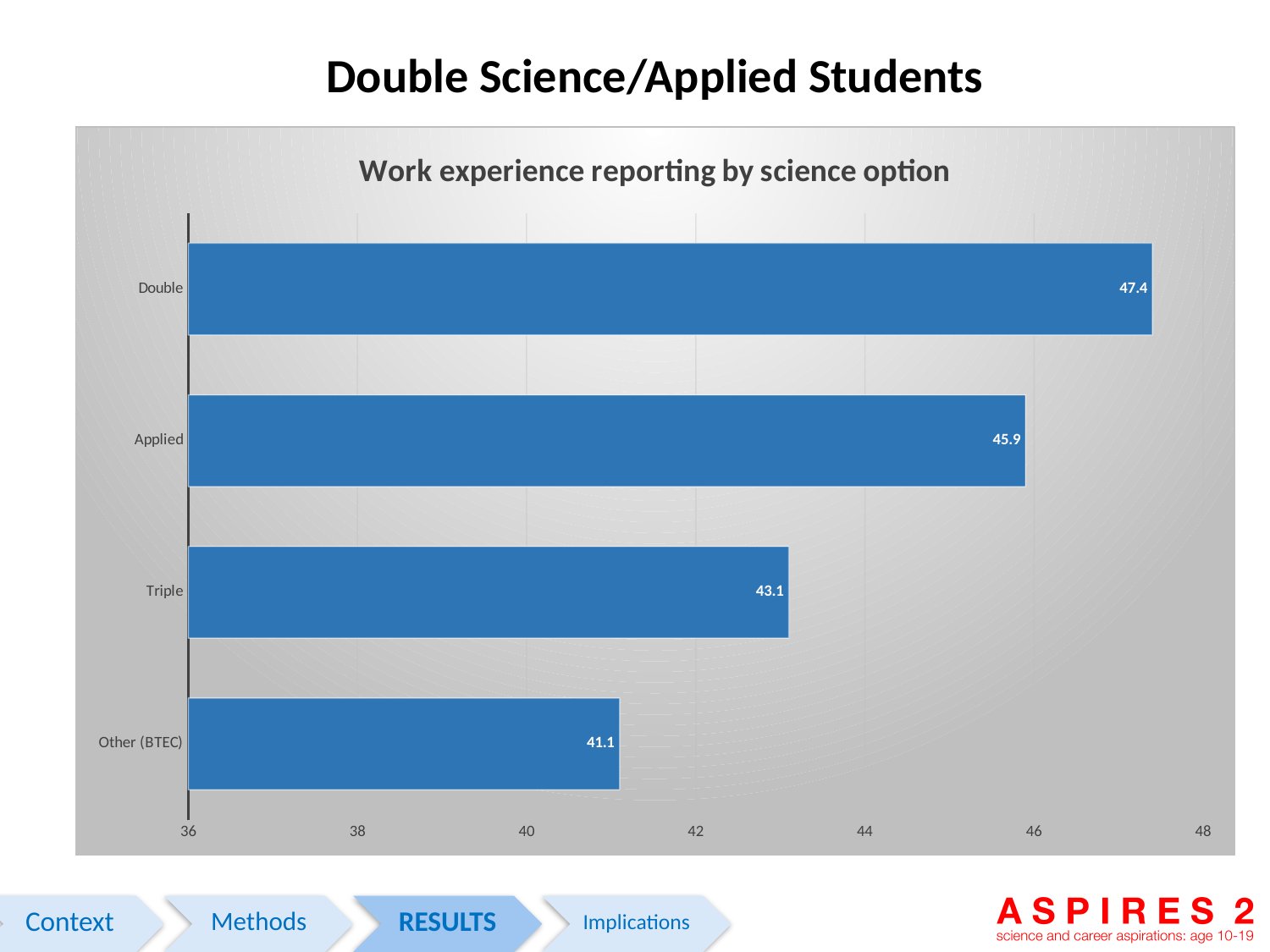
What is the difference between the values for Double and Other (BTEC)? 6.3 How many science options are shown in the chart? 4 Which science option has the highest value? Double What is the value for Triple? 43.1 What type of chart is shown? bar chart What is the value for Other (BTEC)? 41.1 What is the value for Applied? 45.9 What is the difference between the values for Applied and Triple? 2.8 Is the value for Triple greater or less than 44? less Which is larger, the value for Applied or the value for Triple? Applied What is the value for Double? 47.4 Which science option has the lowest value? Other (BTEC)